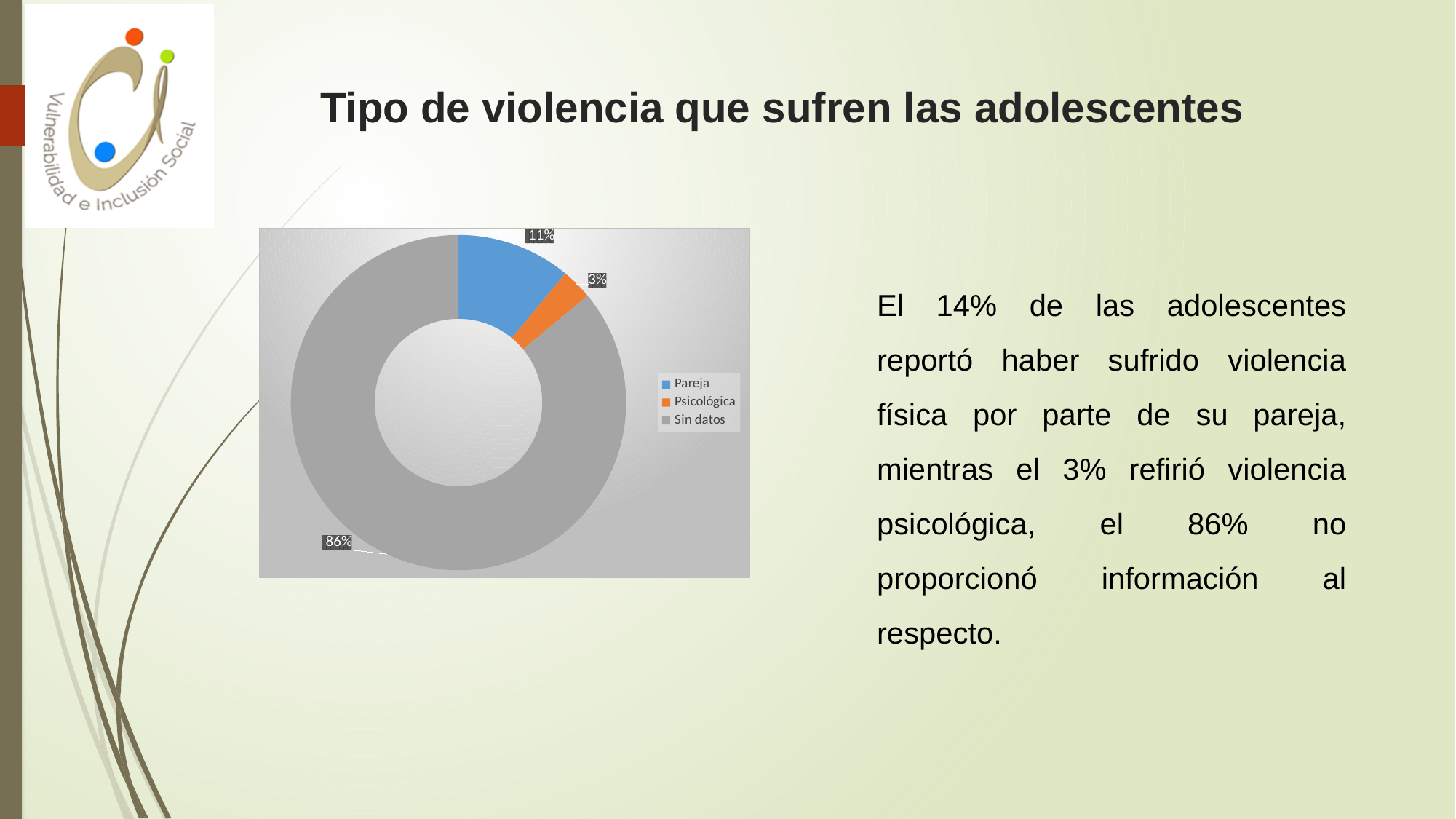
Which is larger, the Pareja slice or the Psicológica slice? Pareja Which category has the smallest share of the doughnut? Psicológica What percentage does the Pareja slice show? 11% What is the combined percentage of the Pareja and Psicológica slices? 14% What percentage does the Sin datos slice show? 86% What is the difference in percentage points between the Sin datos slice and the Pareja slice? 75 How many categories does the legend list? 3 What percentage does the Psicológica slice show? 3% Which category has the largest share of the doughnut? Sin datos What colour is the Sin datos slice? Grey What kind of chart is shown on the slide? Doughnut chart What is the title of the slide containing the chart? Tipo de violencia que sufren las adolescentes